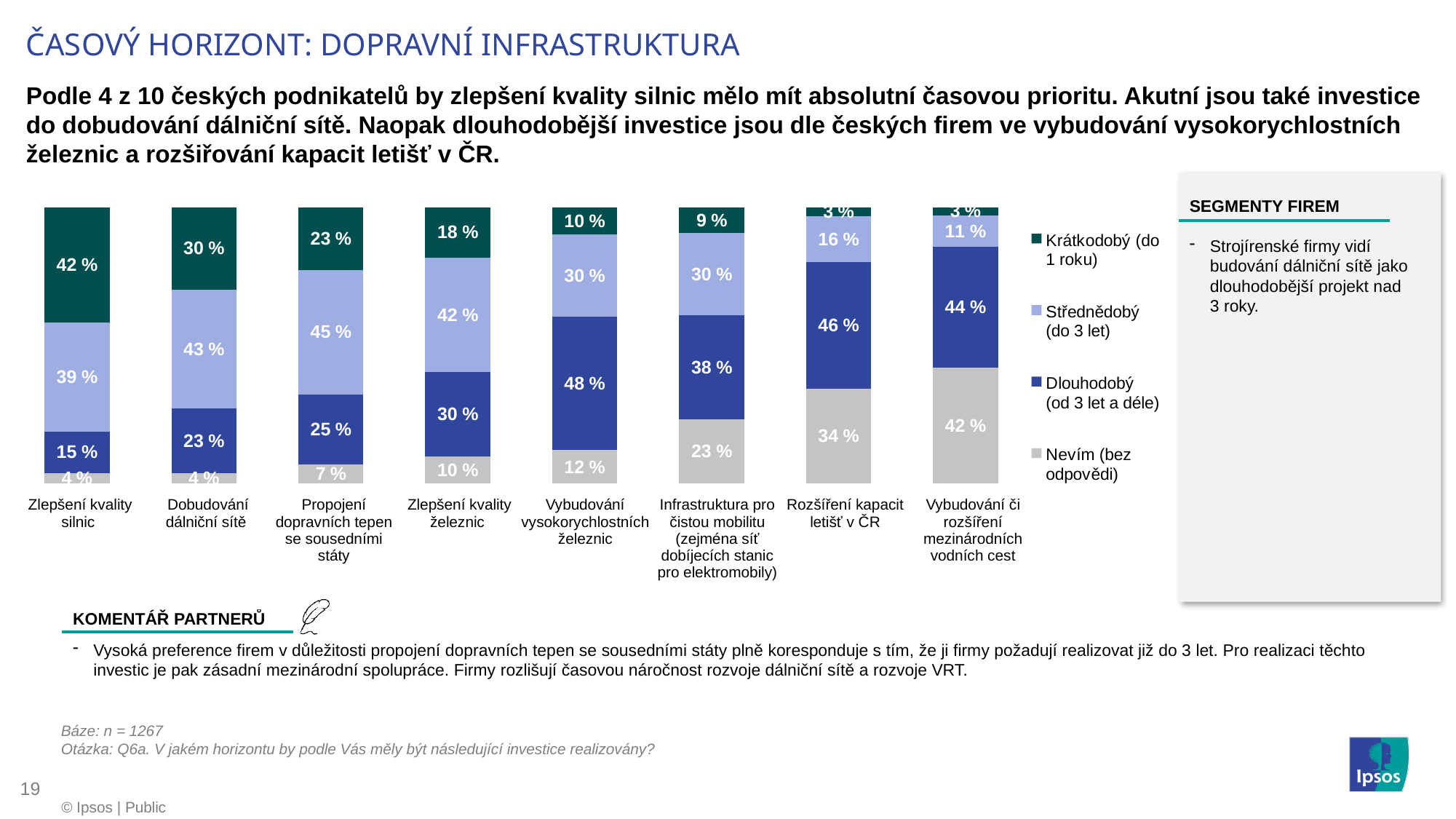
What is the Střednědobý (do 3 let) value for Propojení dopravních tepen se sousedními státy? 45 % Which category has the lowest Nevím (bez odpovědi) value? Zlepšení kvality silnic and Dobudování dálniční sítě (both 4 %) What is the Dlouhodobý (od 3 let a déle) value for Vybudování vysokorychlostních železnic? 48 % Which category has the highest Krátkodobý (do 1 roku) value? Zlepšení kvality silnic How many categories (investment areas) are shown on the x axis of the chart? 8 What is the Krátkodobý (do 1 roku) value for Zlepšení kvality silnic? 42 % Which legend entry is shown in the darkest green colour? Krátkodobý (do 1 roku) How many series does the chart legend list? 4 Which is larger: the Střednědobý (do 3 let) value for Dobudování dálniční sítě or for Zlepšení kvality železnic? Dobudování dálniční sítě What is the difference between the Dlouhodobý (od 3 let a déle) values for Dobudování dálniční sítě and Zlepšení kvality silnic? 8 % What type of chart is shown on the slide? Stacked bar chart What is the Nevím (bez odpovědi) value for Rozšíření kapacit letišť v ČR? 34 %